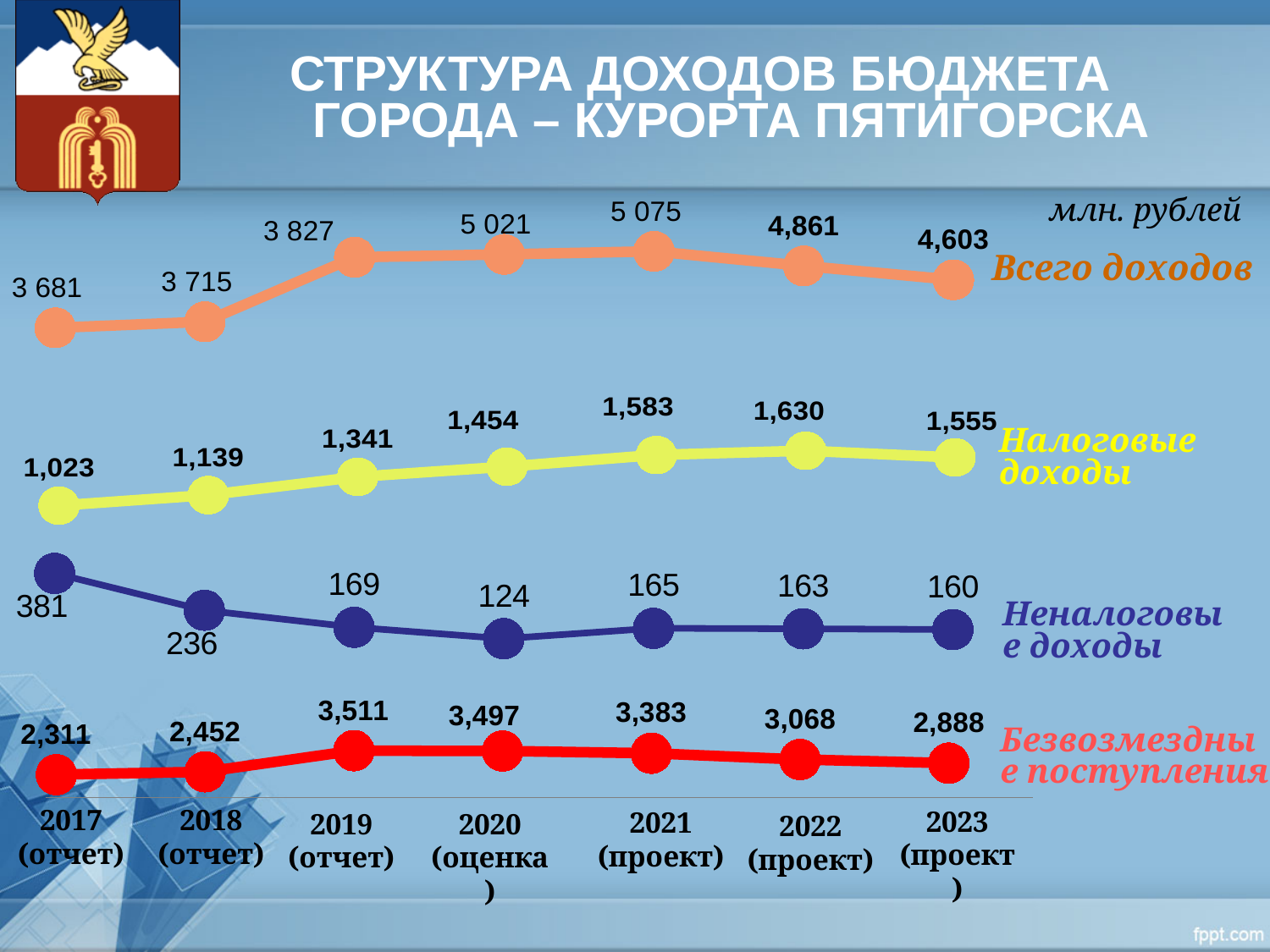
What is the value of Неналоговые доходы for 2020 (оценка)? 124 What kind of chart is shown on the slide? line chart What is the value of Безвозмездные поступления for 2023 (проект)? 2,888 What is the value of Налоговые доходы for 2019 (отчет)? 1,341 Does Неналоговые доходы rise or fall from 2017 to 2020? fall In which year is Налоговые доходы highest? 2022 (проект) In which year is Неналоговые доходы lowest? 2020 (оценка) What is the difference between Безвозмездные поступления in 2019 and in 2017? 1,200 Which is larger: Налоговые доходы in 2023 or Налоговые доходы in 2022? 2022 How many years are shown on the x axis? 7 What is the value of Всего доходов for 2021 (проект)? 5 075 How many series does the chart show? 4